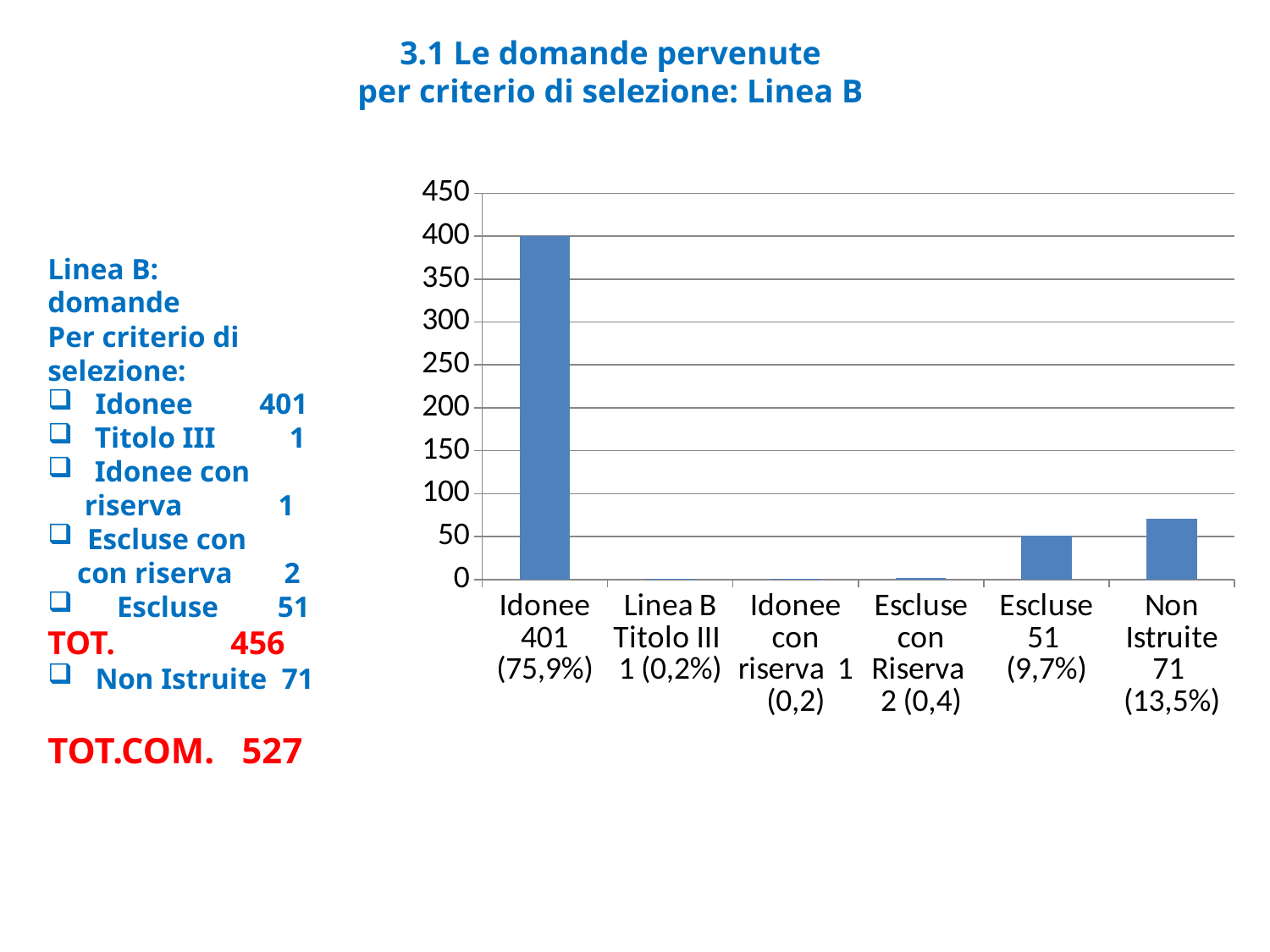
What kind of chart is shown on the slide? bar chart What is the value for Escluse in the chart? 51 What is the value for Idonee in the chart? 401 What is the title of the slide containing the chart? 3.1 Le domande pervenute per criterio di selezione: Linea B Which category has the highest value in the chart? Idonee What is the difference between the values for Non Istruite and Escluse? 20 What percentage is shown for Non Istruite in the chart's category label? 13,5% Is the value for Idonee greater or less than 350? greater How many categories are plotted on the x axis of the chart? 6 What is the value for Non Istruite in the chart? 71 Which is larger, the value for Escluse or the value for Non Istruite? Non Istruite What is the value for Escluse con Riserva in the chart? 2